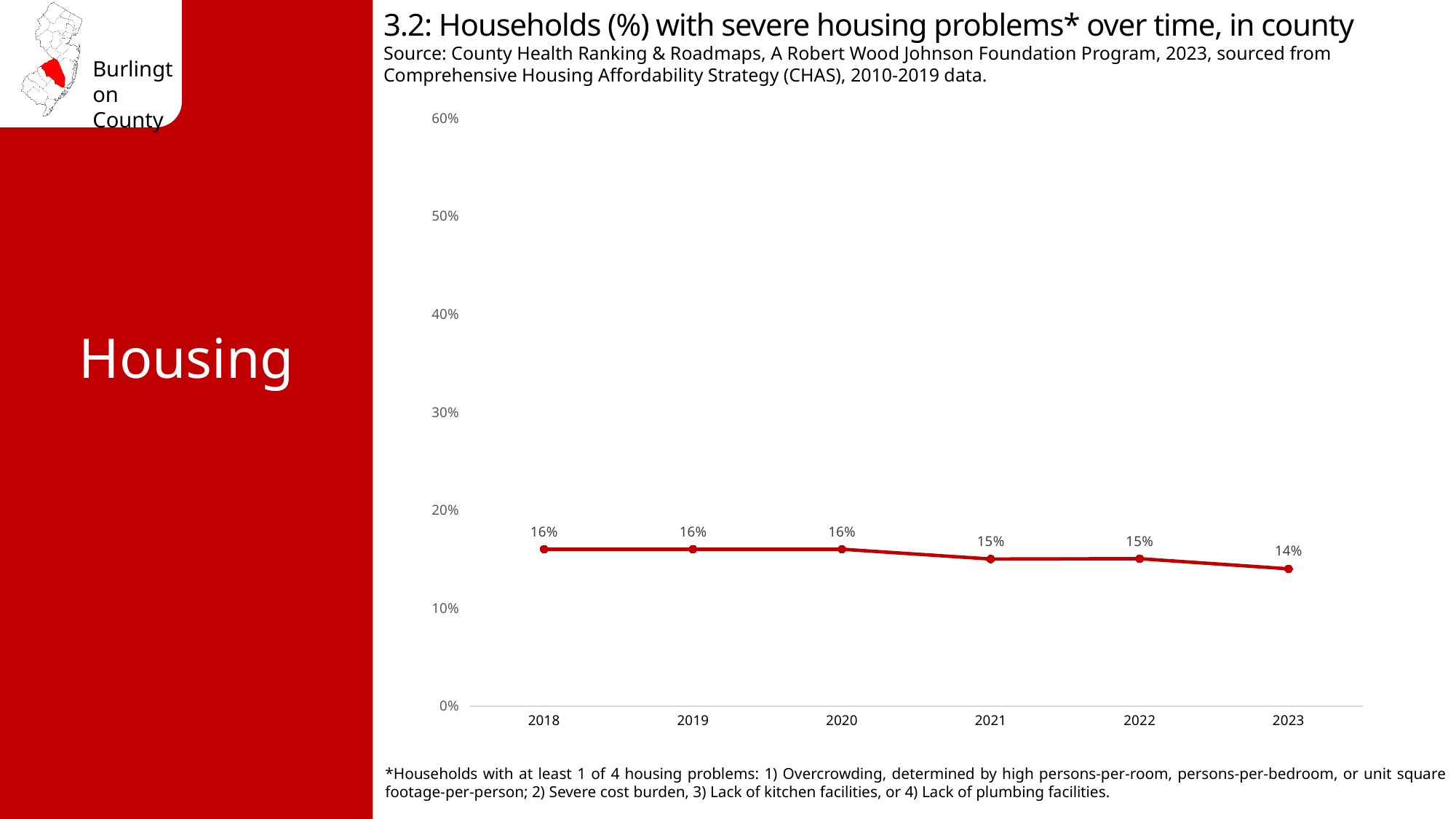
Which is larger, the value for 2020 or the value for 2022? 2020 What percentage of households had severe housing problems in 2023? 14% What kind of chart is shown on the slide? line chart What percentage of households had severe housing problems in 2018? 16% What is the title of the chart? 3.2: Households (%) with severe housing problems* over time, in county What percentage of households had severe housing problems in 2021? 15% What is the difference between the 2018 value and the 2023 value? 2% What is the highest value shown on the y axis? 60% Is the value for 2019 greater or less than 20%? less Which year has the lowest percentage of households with severe housing problems? 2023 How many years are plotted on the chart? 6 Do the values rise or fall from 2018 to 2023? fall